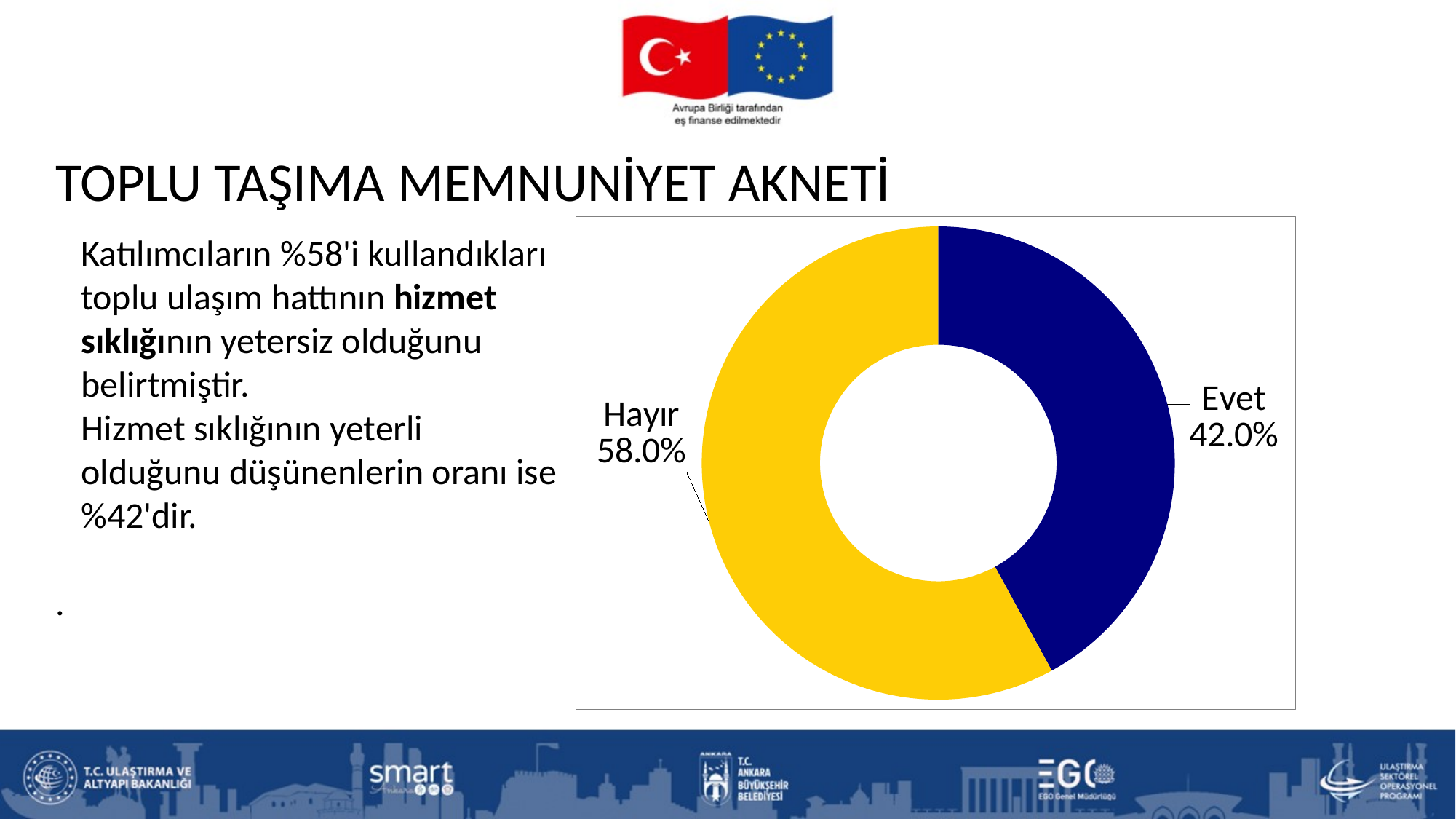
What kind of chart is shown on the slide? Doughnut chart Which slice is the smallest in the chart? Evet What is the difference in percentage points between the Hayır and Evet slices? 16.0% Which slice is the largest in the chart? Hayır How many slices does the chart have? 2 Which is larger, the Evet slice or the Hayır slice? Hayır What is the total of the two slices shown in the chart? 100.0% What colour is the Hayır slice? Yellow What share of the chart does the Hayır slice represent? 58.0% What colour is the Evet slice? Dark blue What share of the chart does the Evet slice represent? 42.0%